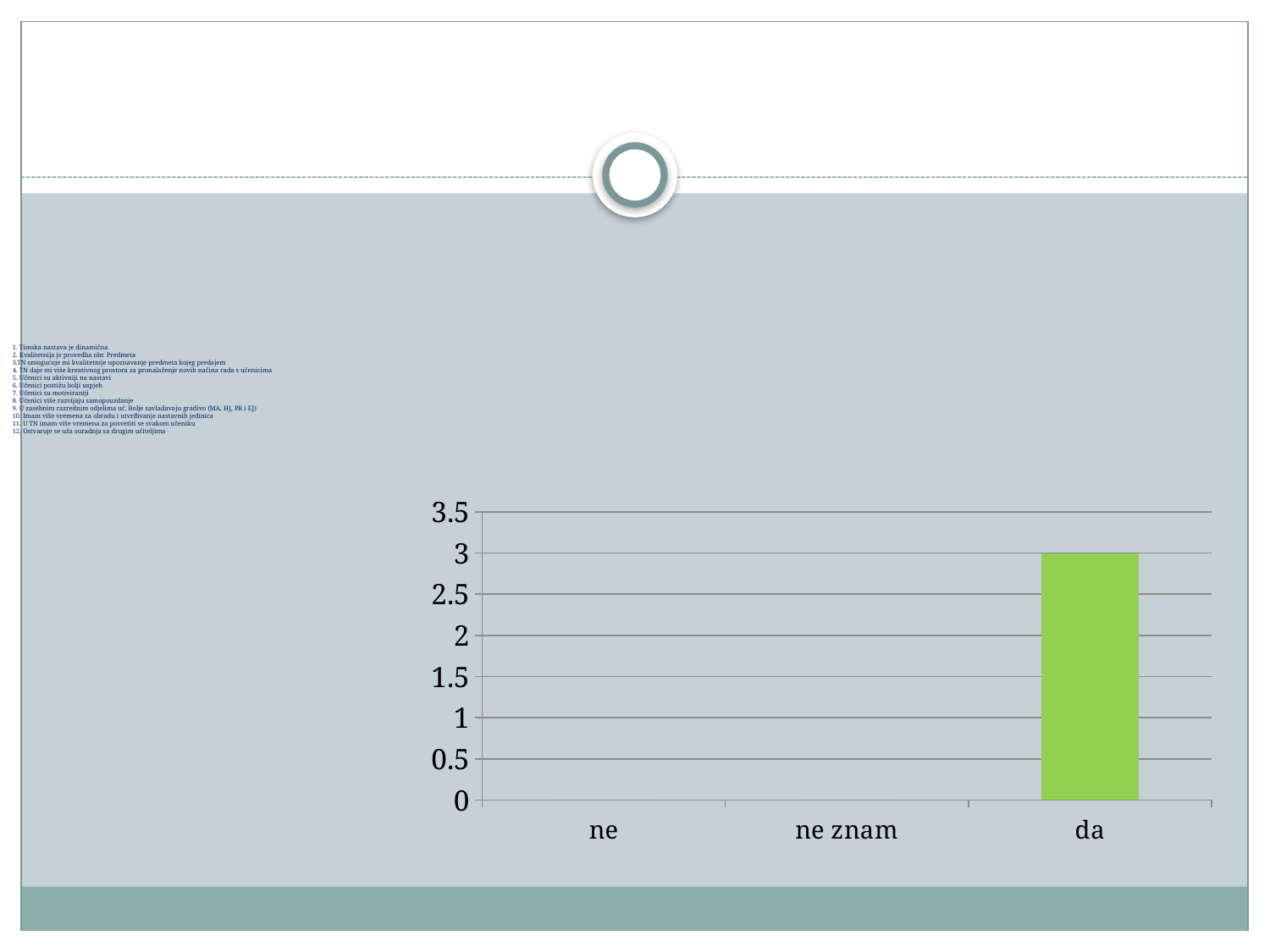
Which category has the highest value in the chart? da What kind of chart is shown on the slide? bar chart What is the value for "da" in the chart? 3 Which is larger, the value for "da" or the value for "ne znam"? da How many categories are shown on the x axis of the chart? 3 Is the value for "da" greater or less than 3.5? less Which is larger, the value for "da" or the value for "ne"? da What is the highest value shown on the y axis of the chart? 3.5 Is the value for "da" greater or less than 2? greater What colour is the bar for "da"? green Which category appears first on the x axis of the chart? ne